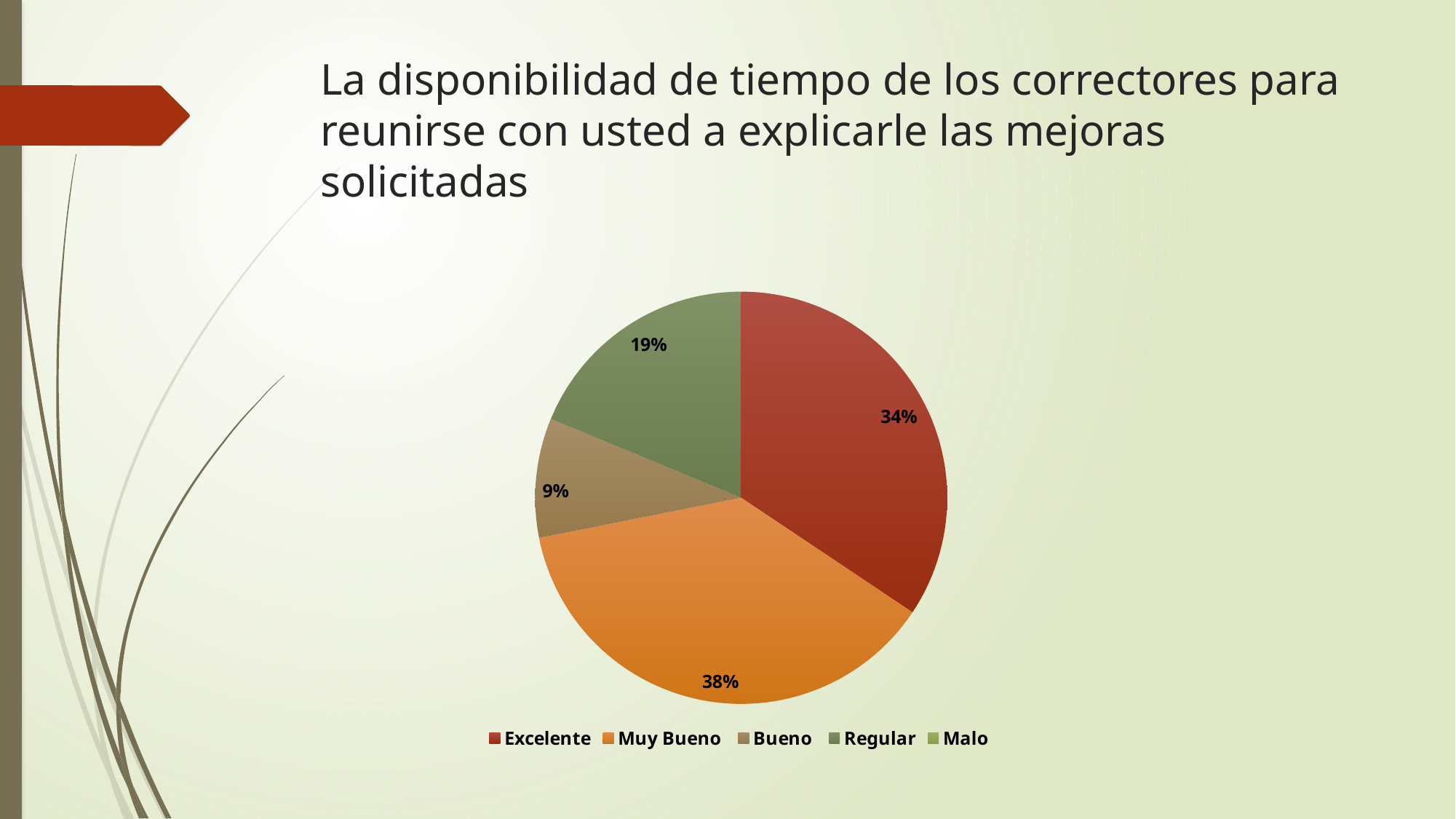
What is the difference in percentage points between the Muy Bueno and Excelente slices? 4 What colour is the Excelente slice in the pie chart? red Which slice is larger, Regular or Bueno? Regular Which labelled slice of the pie is the smallest? Bueno What percentage of the pie is labelled for Regular? 19% How many slices with percentage labels are visible in the pie? 4 What percentage of the pie is labelled for Muy Bueno? 38% How many entries does the legend list? 5 Which category has the largest slice of the pie? Muy Bueno What kind of chart is shown on the slide? pie chart What percentage of the pie is labelled for Bueno? 9% What percentage of the pie is labelled for Excelente? 34%